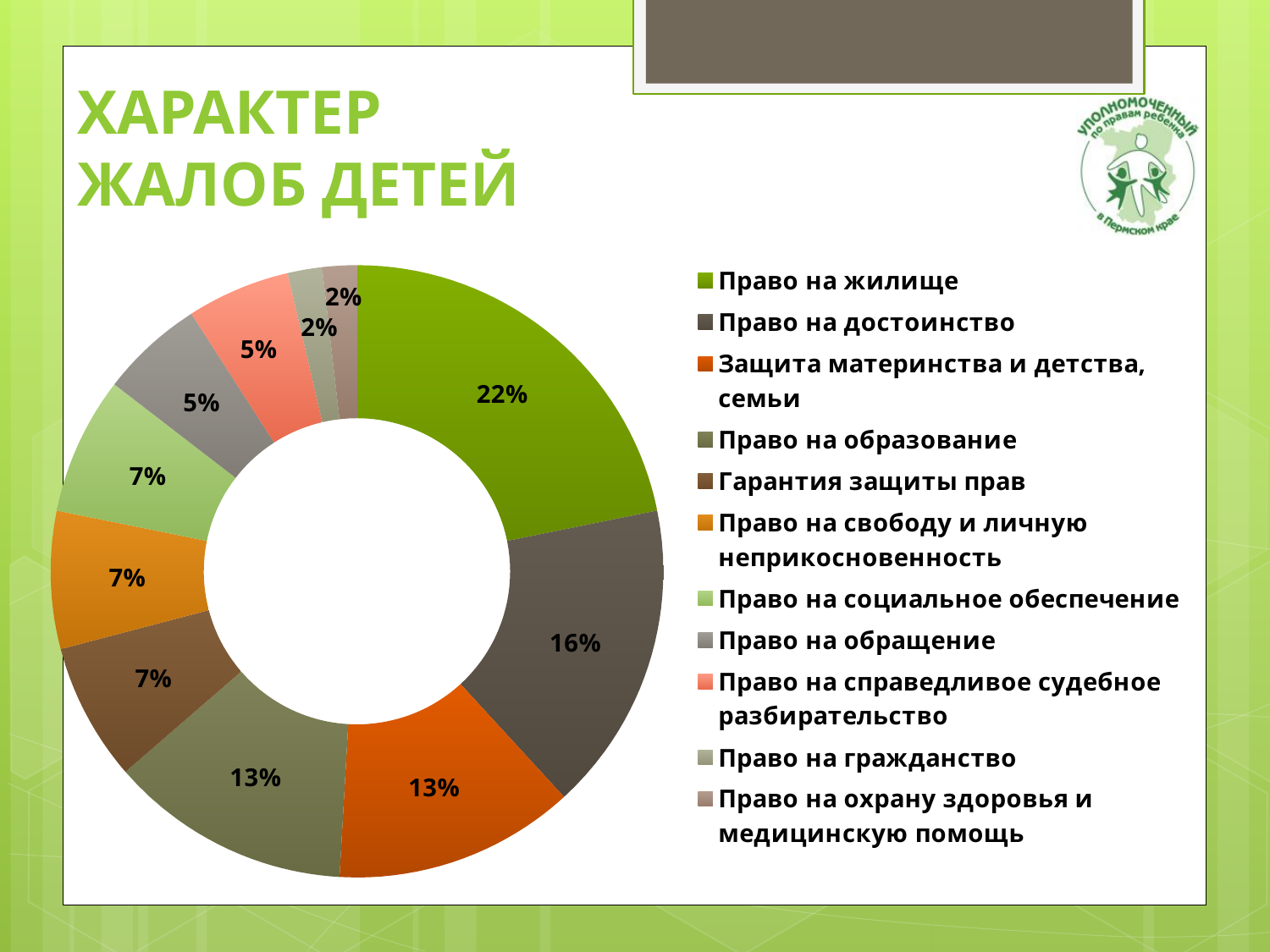
What is the title of the slide containing the chart? ХАРАКТЕР ЖАЛОБ ДЕТЕЙ What share of the chart does "Право на достоинство" represent? 16% What share of the chart does "Право на гражданство" represent? 2% How many categories are shown in the chart? 11 Which category has the largest share of the chart? Право на жилище What share of the chart does "Право на обращение" represent? 5% What share of the chart does "Право на жилище" represent? 22% What share of the chart does "Защита материнства и детства, семьи" represent? 13% What is the difference between the shares of "Право на жилище" and "Право на достоинство"? 6% What kind of chart is shown on the slide? Pie (doughnut) chart Which is larger: the share of "Право на образование" or the share of "Гарантия защиты прав"? Право на образование What is the smallest share shown on the chart? 2%